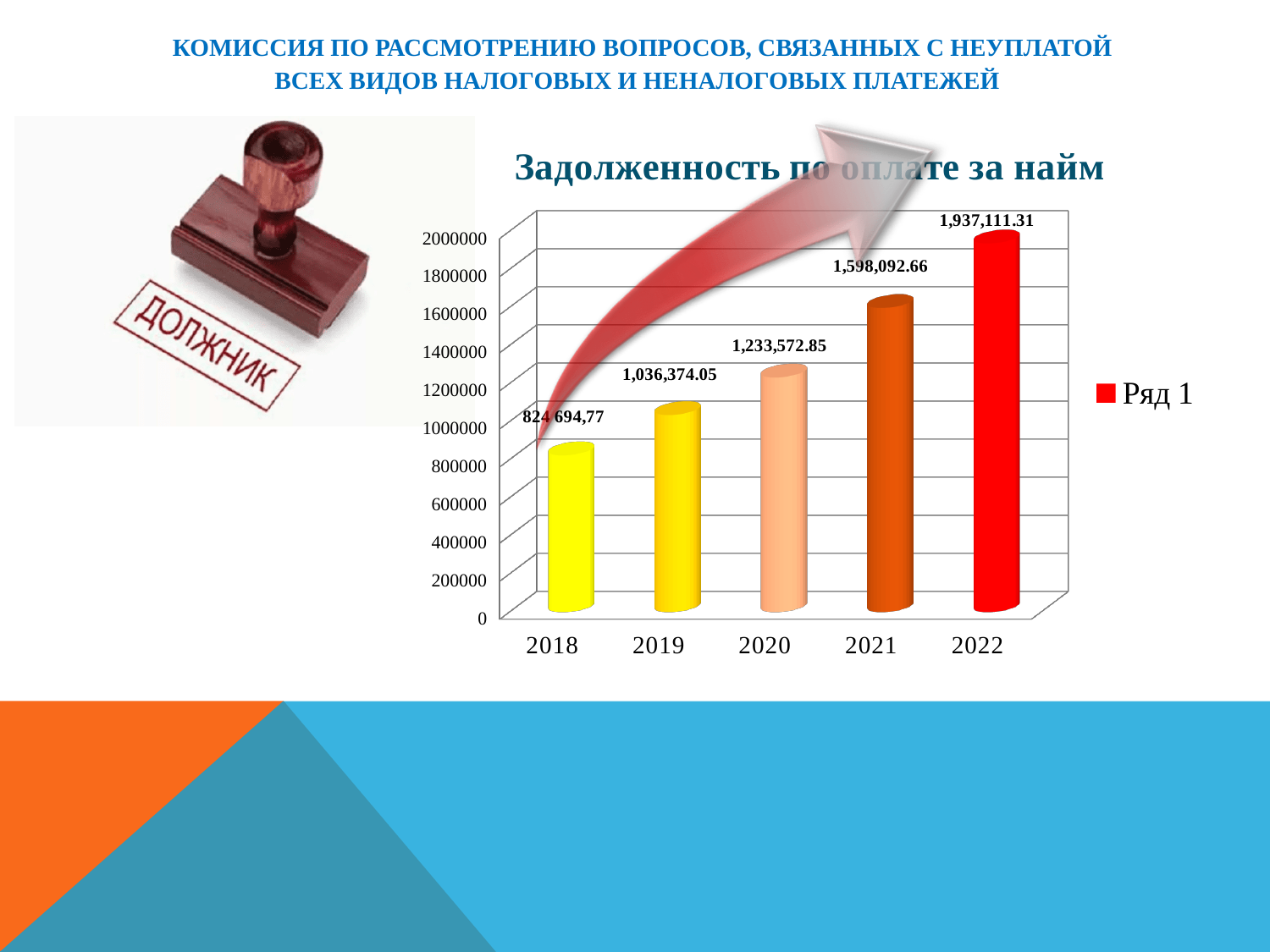
Do the values rise or fall from 2018 to 2022? rise Which year has the lowest value in the chart? 2018 What is the difference between the values for 2020 and 2019? 197,198.80 Is the value for 2021 greater or less than 1400000? greater What is the difference between the values for 2022 and 2021? 339,018.65 What is the value for 2022 in the chart? 1,937,111.31 Which is larger, the value for 2020 or the value for 2021? 2021 Which year has the highest value in the chart? 2022 How many years are shown on the x axis of the chart? 5 What kind of chart is shown on the slide? bar chart What is the value for 2018 in the chart? 824 694,77 What is the value for 2019 in the chart? 1,036,374.05